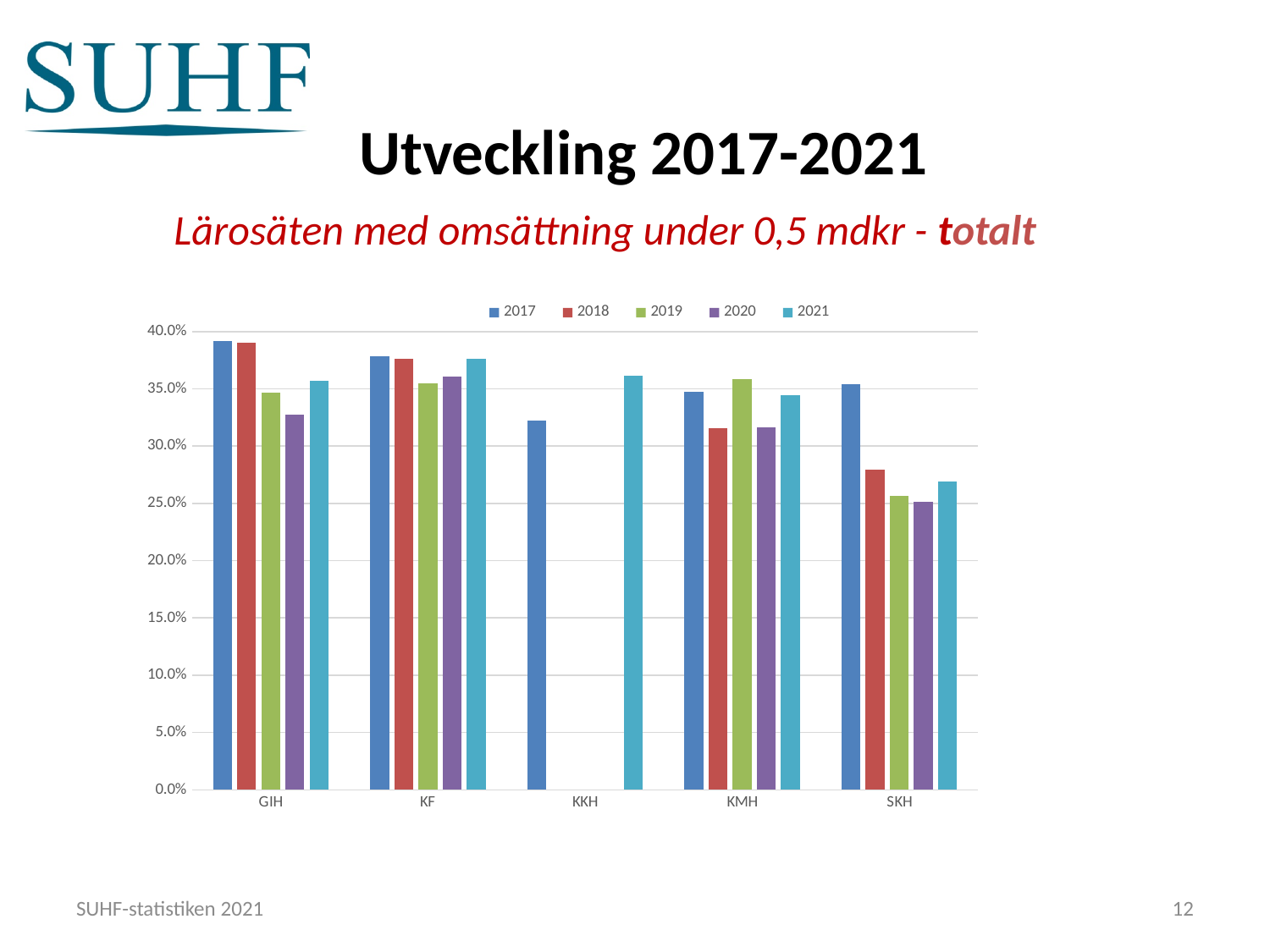
Which category has bars for only two of the years? KKH What kind of chart is shown on the slide? bar chart For KKH, which is larger: the 2017 value or the 2021 value? 2021 For GIH, which year has the lowest value? 2020 For SKH, which is larger: the 2017 value or the 2018 value? 2017 How many categories (institutions) are shown on the x axis? 5 Is the value for SKH in 2020 greater or less than 30.0%? less How many series does the legend list? 5 For SKH, which year has the highest value? 2017 For SKH, do the values rise or fall from 2017 to 2020? fall Is the value for KMH in 2018 greater or less than 35.0%? less Is the value for GIH in 2017 greater or less than 35.0%? greater